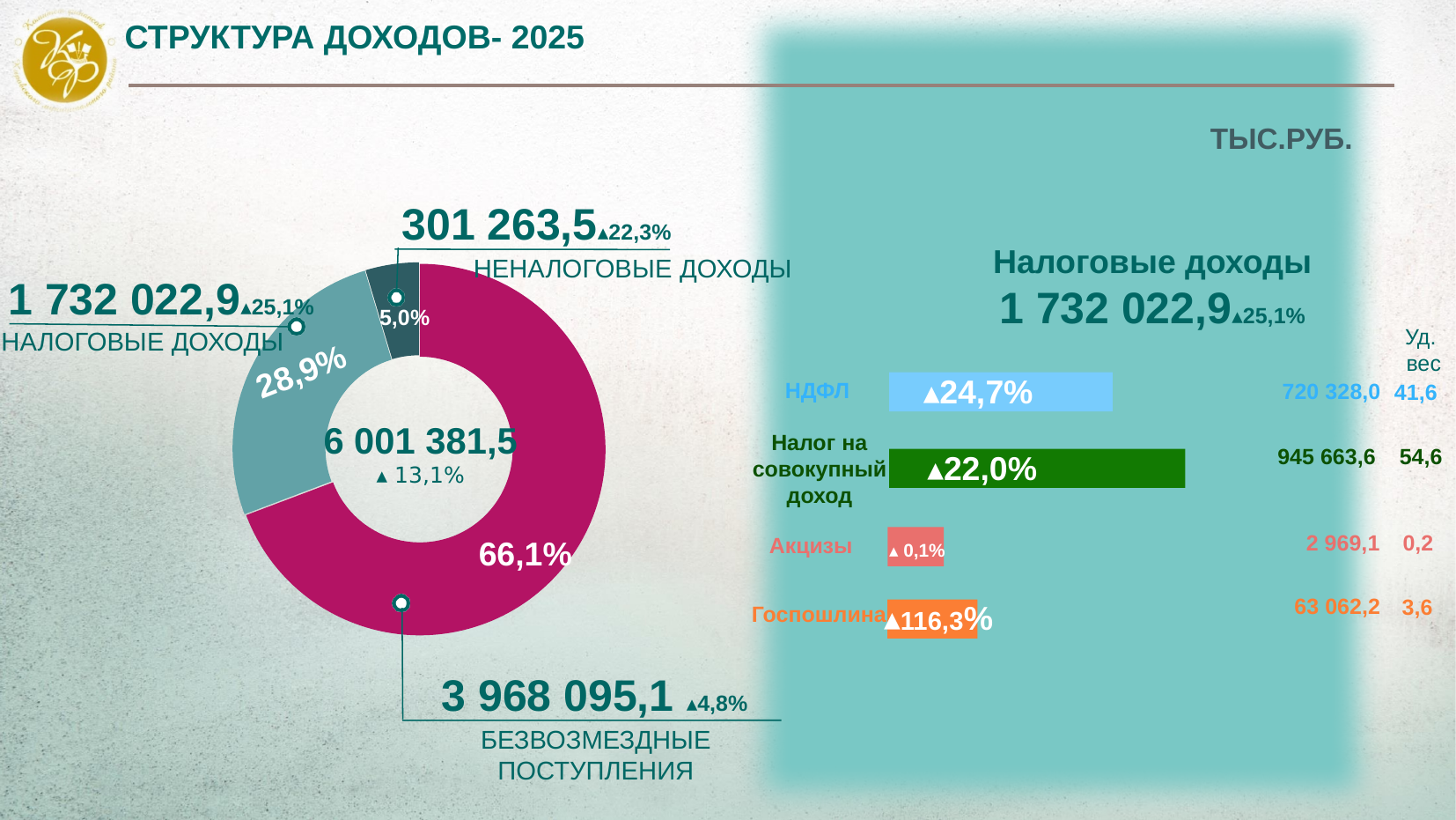
In the donut chart on the left, what share does НАЛОГОВЫЕ ДОХОДЫ have? 28,9% In the donut chart on the left, which category has the largest share? БЕЗВОЗМЕЗДНЫЕ ПОСТУПЛЕНИЯ In the donut chart on the left, what share does БЕЗВОЗМЕЗДНЫЕ ПОСТУПЛЕНИЯ have? 66,1% In the Налоговые доходы bar chart on the right, what is the value shown for Налог на совокупный доход? 945 663,6 In the Налоговые доходы bar chart on the right, which is larger in value: НДФЛ or Налог на совокупный доход? Налог на совокупный доход In the donut chart on the left, what total value is printed in the centre? 6 001 381,5 In the Налоговые доходы bar chart on the right, which category has the highest growth percentage? Госпошлина In the Налоговые доходы bar chart on the right, what growth percentage is shown for НДФЛ? ▲24,7% In the donut chart on the left, which category has the smallest share? НЕНАЛОГОВЫЕ ДОХОДЫ In the donut chart on the left, what is the value shown for БЕЗВОЗМЕЗДНЫЕ ПОСТУПЛЕНИЯ? 3 968 095,1 In the donut chart on the left, what is the value shown for НЕНАЛОГОВЫЕ ДОХОДЫ? 301 263,5 In the donut chart on the left, how many categories are shown? 3